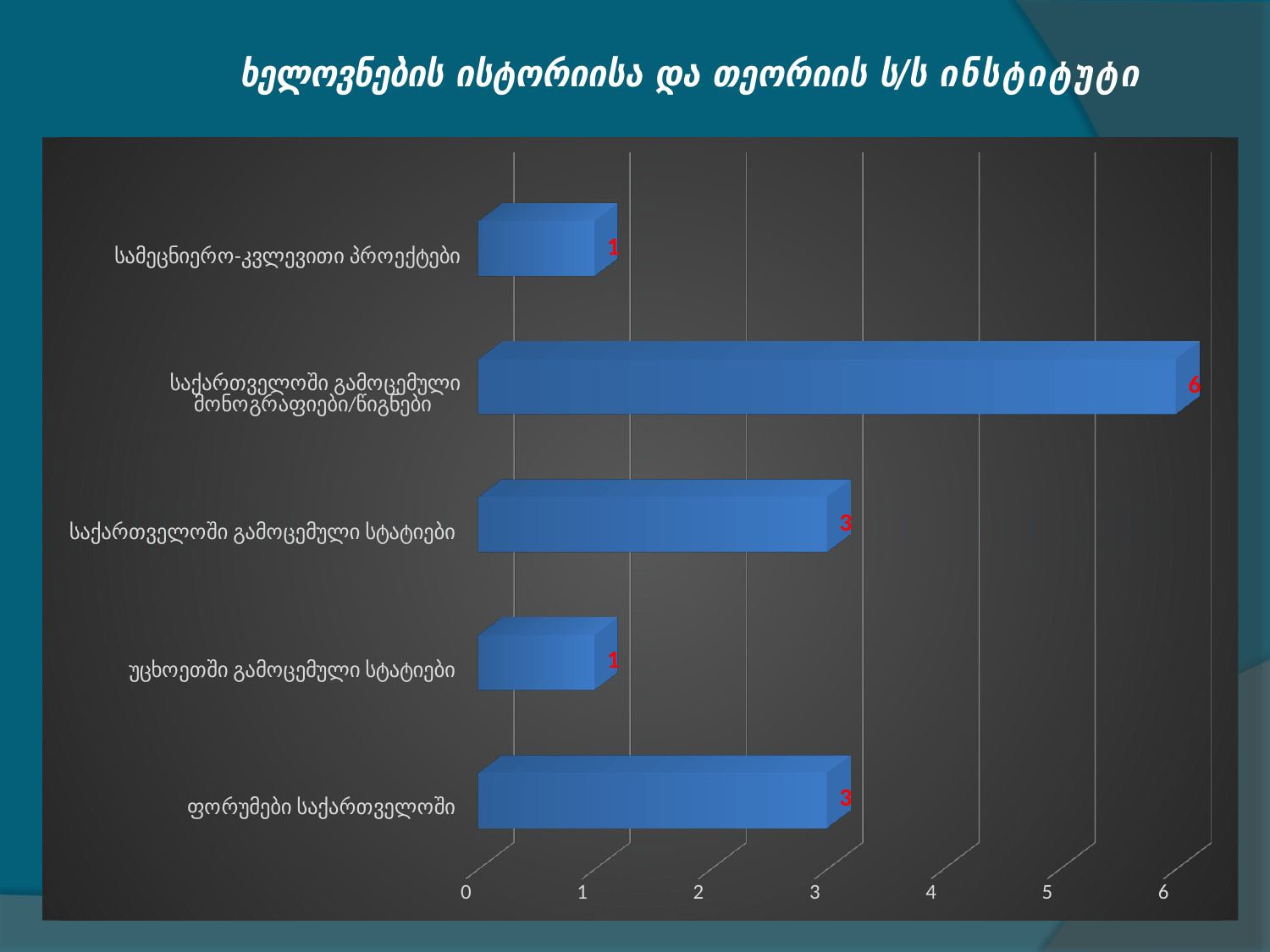
How many categories are shown in the chart? 5 What is the value for საქართველოში გამოცემული მონოგრაფიები/წიგნები? 6 What kind of chart is shown on the slide? bar chart What is the value for სამეცნიერო-კვლევითი პროექტები? 1 What is the value for ფორუმები საქართველოში? 3 Which category has the highest value? საქართველოში გამოცემული მონოგრაფიები/წიგნები Which is larger: the value for ფორუმები საქართველოში or the value for უცხოეთში გამოცემული სტატიები? ფორუმები საქართველოში What is the difference between the values for საქართველოში გამოცემული მონოგრაფიები/წიგნები and საქართველოში გამოცემული სტატიები? 3 What is the value for საქართველოში გამოცემული სტატიები? 3 What is the value for უცხოეთში გამოცემული სტატიები? 1 Is the value for საქართველოში გამოცემული მონოგრაფიები/წიგნები greater or less than 5? greater What is the title of the slide? ხელოვნების ისტორიისა და თეორიის ს/ს ინსტიტუტი